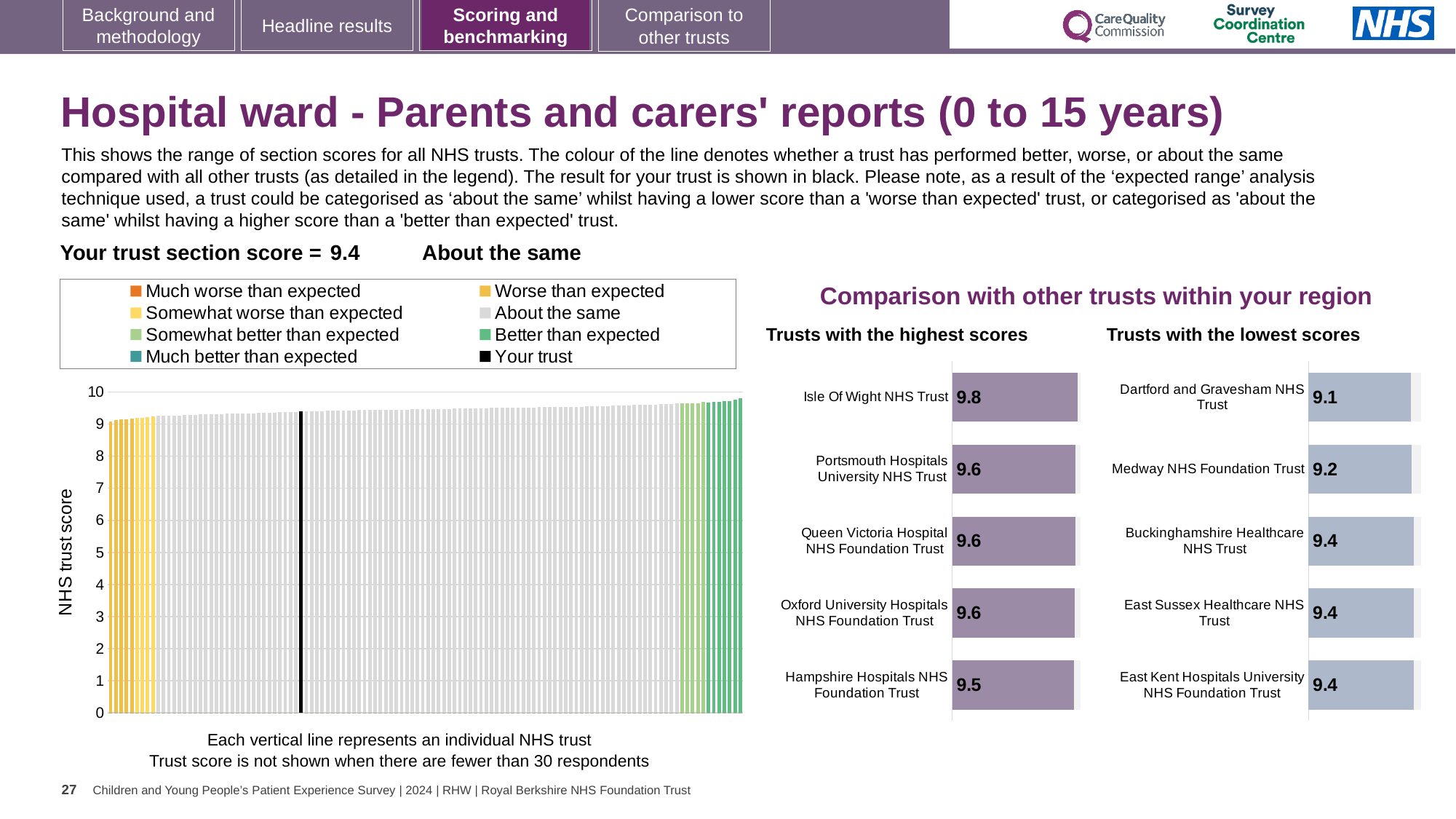
What type of chart is the 'Trusts with the highest scores' chart? Bar chart In the 'Trusts with the lowest scores' chart, what is the score for Medway NHS Foundation Trust? 9.2 In the 'Trusts with the highest scores' chart, what is the score for Hampshire Hospitals NHS Foundation Trust? 9.5 In the 'Trusts with the highest scores' chart, which trust has the highest score? Isle Of Wight NHS Trust How many trusts are shown in the 'Trusts with the highest scores' chart? 5 In the 'Trusts with the highest scores' chart, what is the score for Isle Of Wight NHS Trust? 9.8 In the main chart on the left, what is the section score for your trust (the black line)? 9.4 In the 'Trusts with the lowest scores' chart, which has the larger score: Medway NHS Foundation Trust or Buckinghamshire Healthcare NHS Trust? Buckinghamshire Healthcare NHS Trust What is the difference between the score for Isle Of Wight NHS Trust in the 'highest scores' chart and the score for Dartford and Gravesham NHS Trust in the 'lowest scores' chart? 0.7 In the 'Trusts with the lowest scores' chart, which trust has the lowest score? Dartford and Gravesham NHS Trust In the 'Trusts with the lowest scores' chart, what is the score for Dartford and Gravesham NHS Trust? 9.1 How many entries does the legend of the main chart on the left list? 8